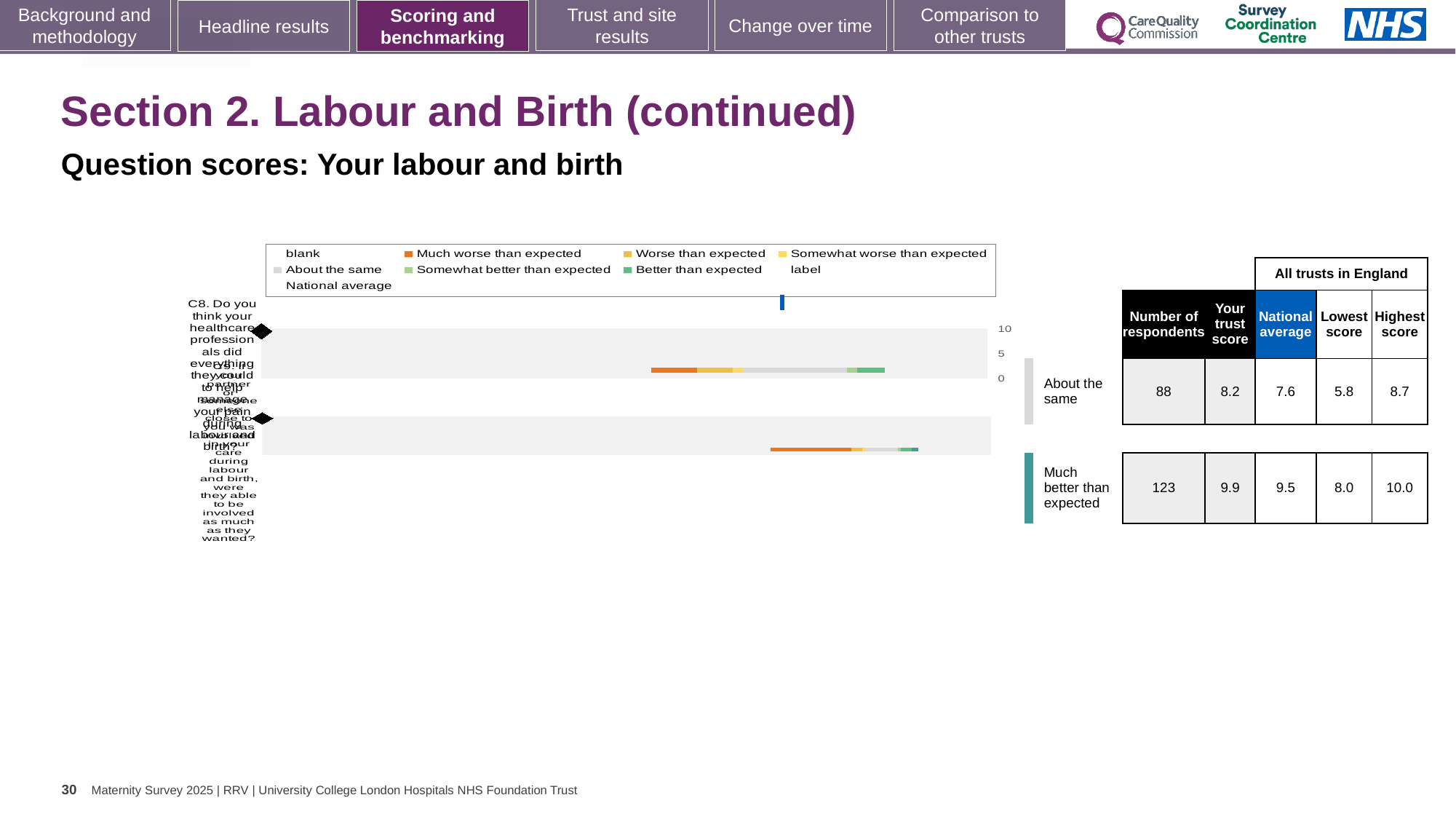
What is the difference in number of respondents between the 'Much better than expected' row and the 'About the same' row? 35 For the row rated 'About the same', how much higher is the trust score than the national average? 0.6 What kind of chart is shown on the slide? bar chart How many question rows (bars) are plotted in the chart? 2 What colour represents 'Much worse than expected' in the chart legend? orange What colour represents 'Better than expected' in the chart legend? green In the table next to the chart, what is the 'Your trust score' for the row rated 'About the same'? 8.2 In the table next to the chart, what is the 'Highest score' for the row rated 'About the same'? 8.7 In the table next to the chart, what is the 'National average' for the row rated 'Much better than expected'? 9.5 In the table next to the chart, how many respondents are listed for the row rated 'Much better than expected'? 123 In the table next to the chart, what is the 'Lowest score' for the row rated 'Much better than expected'? 8.0 Which row has more respondents, 'About the same' or 'Much better than expected'? Much better than expected